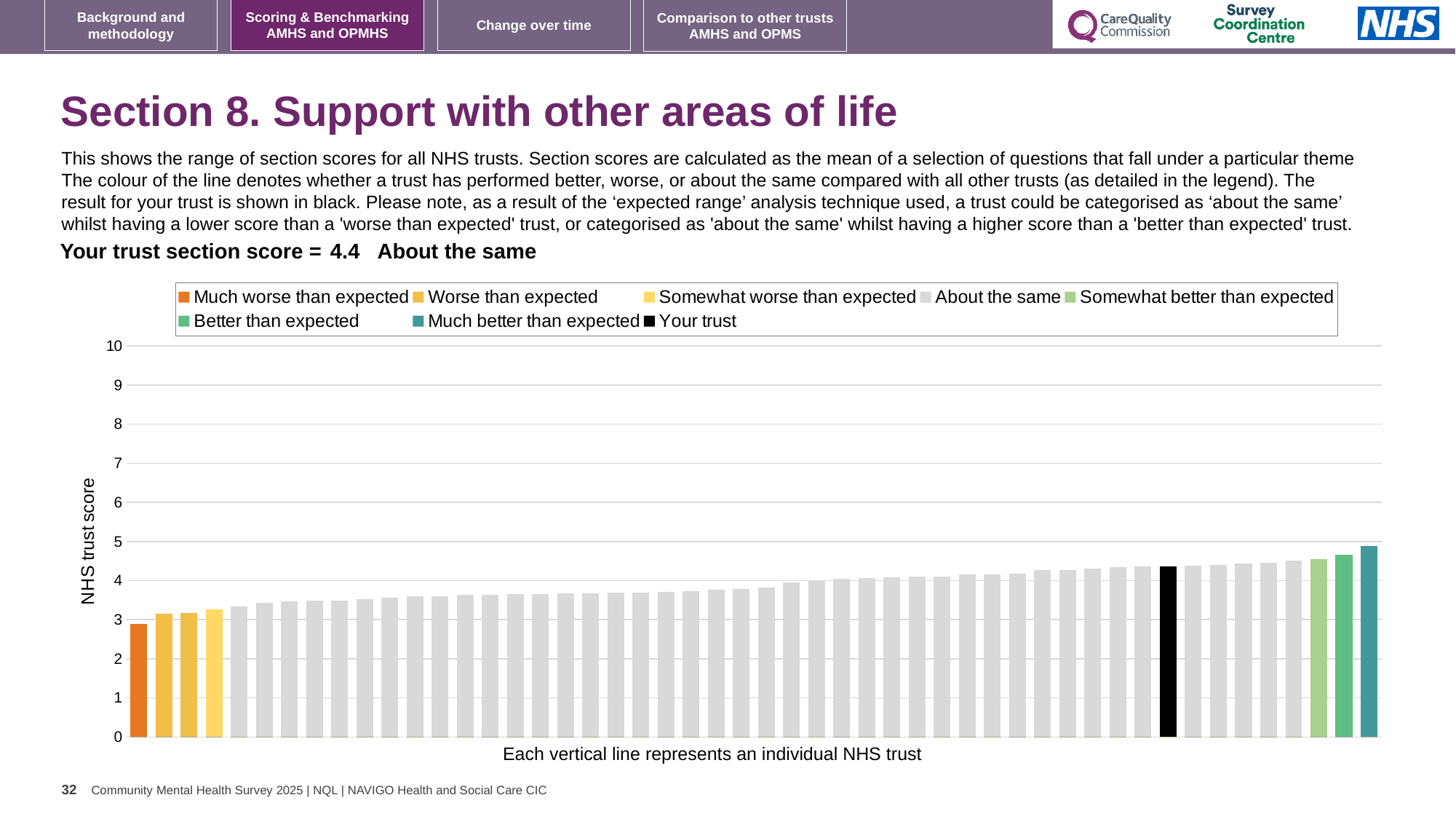
Which legend category does the shortest bar on the chart belong to? Much worse than expected What is the section score for your trust shown on the chart? 4.4 How many entries does the chart legend list? 8 What is the label on the vertical axis of the chart? NHS trust score Is the value of the leftmost (orange) bar greater or less than 2? greater What colour is used for the 'Your trust' bar in the chart? black Do the bar values rise or fall from left to right along the x axis? rise What kind of chart is shown on the slide? bar chart Which is larger: the value for your trust (black bar) or the value of the leftmost orange bar? your trust Is the value of the rightmost (teal) bar greater or less than 4? greater Is the value for your trust (the black bar) greater or less than 4? greater Which legend category does the tallest bar on the chart belong to? Much better than expected